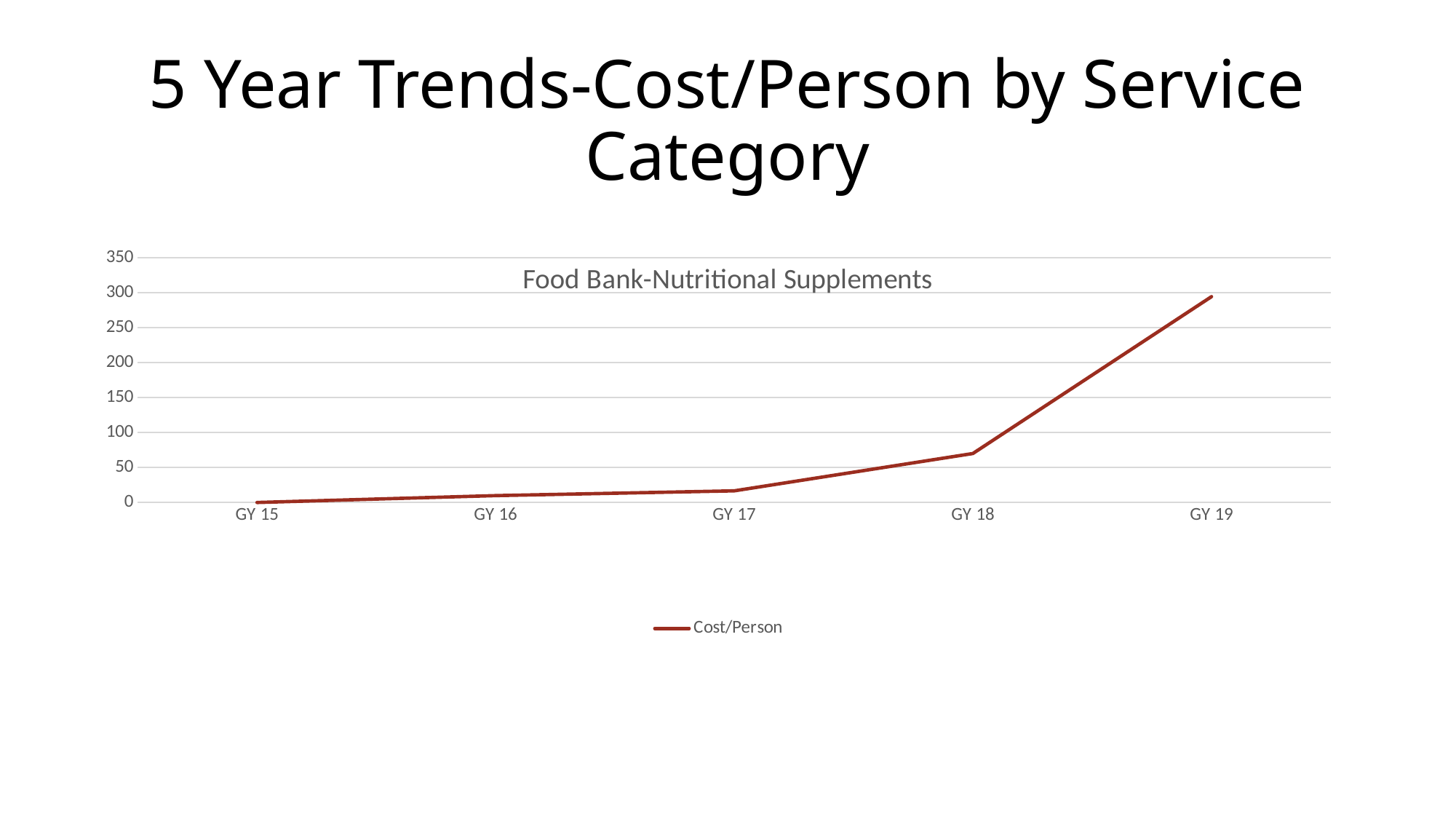
Which grant year has the highest Cost/Person? GY 19 How many series does the legend list? 1 What is the name of the series shown in the legend? Cost/Person What is the title of the chart? Food Bank-Nutritional Supplements Is the Cost/Person value for GY 19 greater or less than 250? greater Do the Cost/Person values rise or fall from GY 15 to GY 19? rise Is the Cost/Person value for GY 18 greater or less than 100? less Which has a larger Cost/Person, GY 17 or GY 18? GY 18 Which has a larger Cost/Person, GY 18 or GY 19? GY 19 What kind of chart is shown on the slide? line chart How many grant years (points) are plotted along the x axis? 5 Is the Cost/Person value for GY 17 greater or less than 50? less